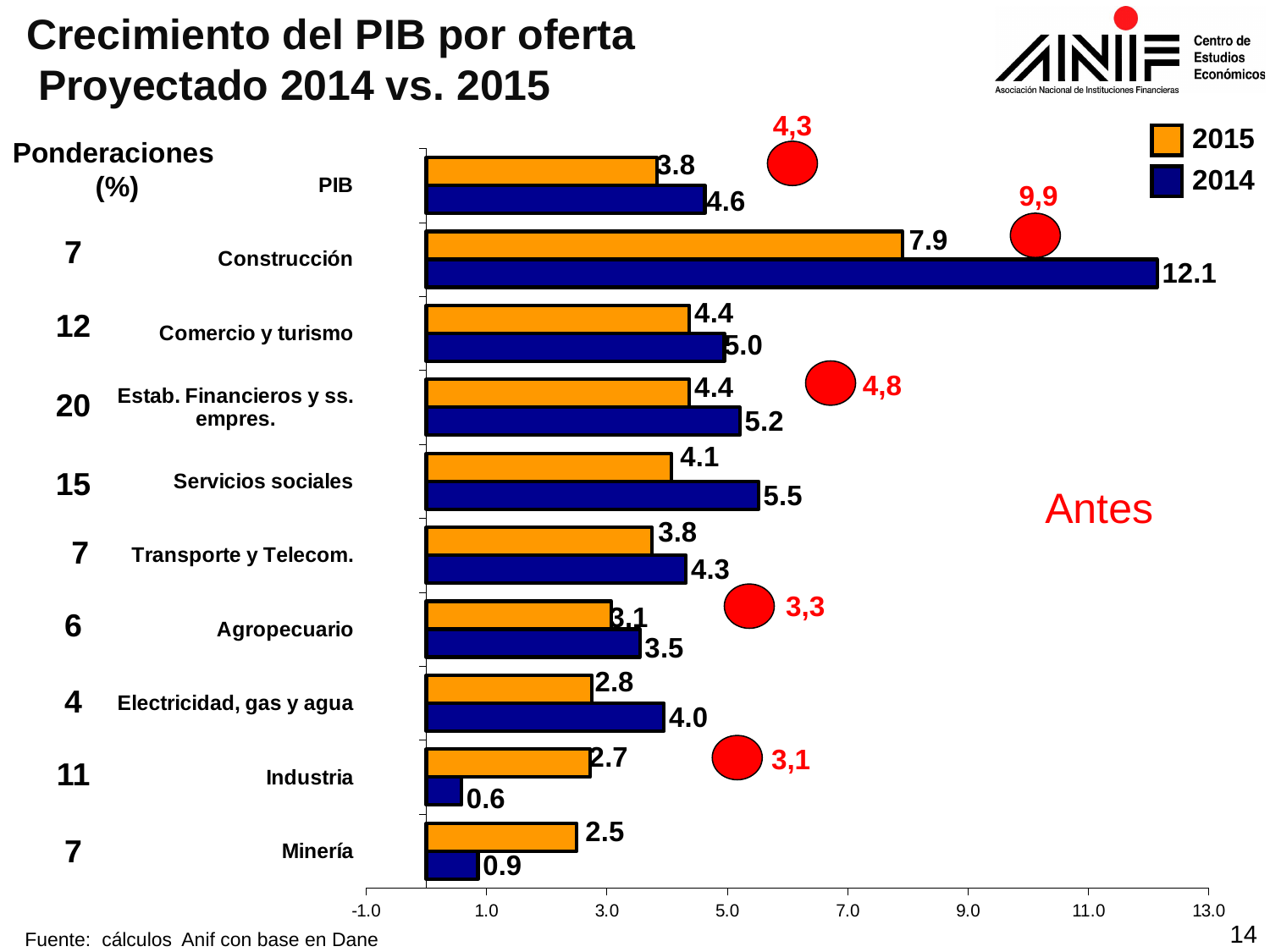
Which category has the lowest 2015 value? Minería What is the 2015 value for Servicios sociales? 4.1 What is the difference between the 2014 and 2015 values for PIB? 0.8 What is the 2014 value for Industria? 0.6 How many categories are plotted on the chart? 10 What is the 2015 value for Construcción? 7.9 Which colour represents the 2015 series in the legend? orange Which category has the highest 2014 value? Construcción What is the difference between the 2014 and 2015 values for Construcción? 4.2 How many series does the legend list? 2 What kind of chart is shown on the slide? bar chart Which is larger for Minería, the 2015 value or the 2014 value? 2015